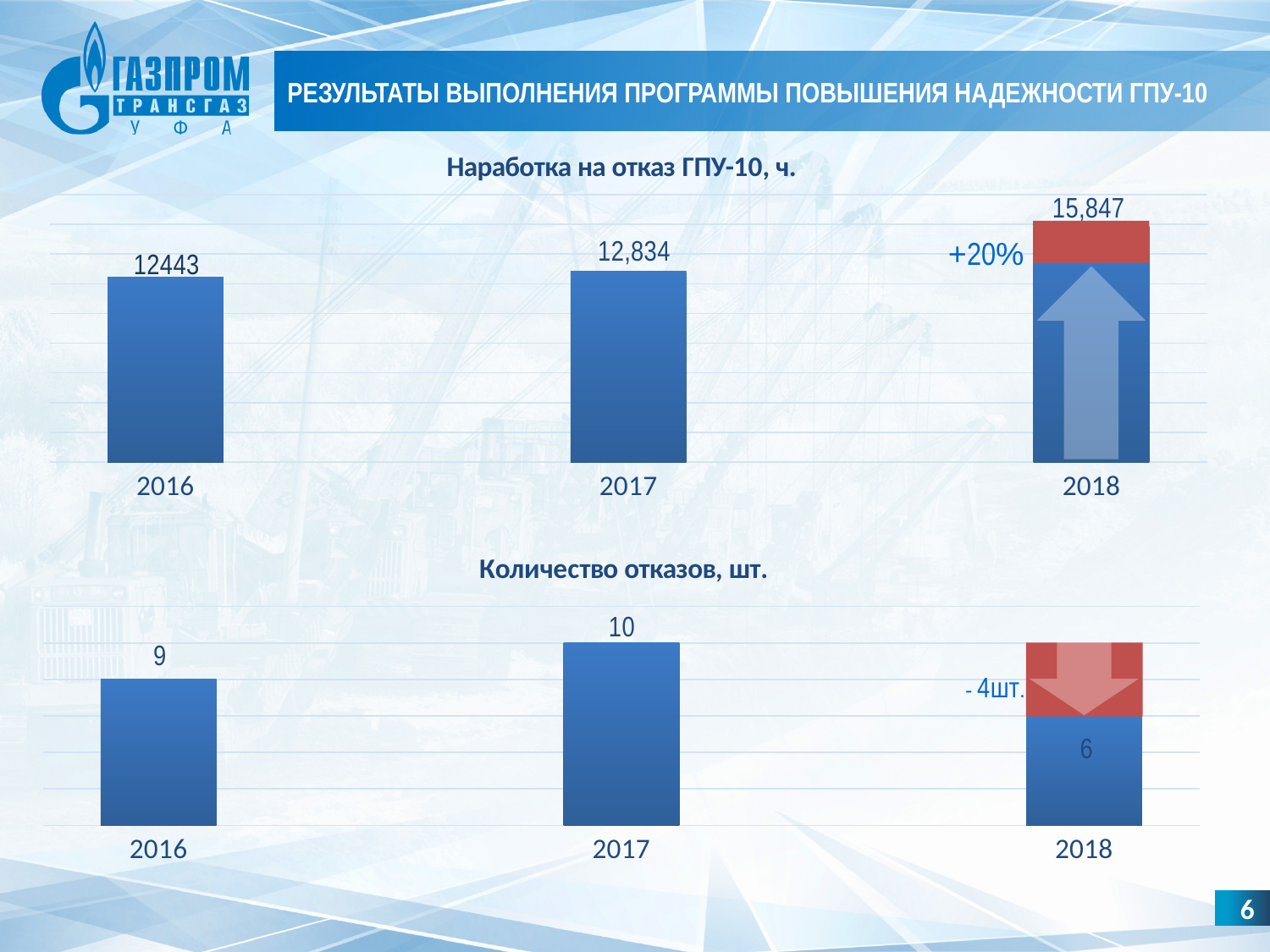
In the chart titled "Наработка на отказ ГПУ-10, ч.", which year has the highest value? 2018 In the chart titled "Наработка на отказ ГПУ-10, ч.", what is the value for 2016? 12443 In the chart titled "Наработка на отказ ГПУ-10, ч.", which year has the lowest value? 2016 In the chart titled "Наработка на отказ ГПУ-10, ч.", do the values rise or fall from 2016 to 2018? rise In the chart titled "Количество отказов, шт.", which year has the lowest value? 2018 In the chart titled "Наработка на отказ ГПУ-10, ч.", what is the difference between the 2018 and 2017 values? 3,013 In the chart titled "Наработка на отказ ГПУ-10, ч.", what is the value for 2018? 15,847 In the chart titled "Количество отказов, шт.", what is the value for 2018? 6 In the chart titled "Количество отказов, шт.", what is the difference between the 2017 and 2018 values? 4 In the chart titled "Количество отказов, шт.", what is the value for 2017? 10 In the chart titled "Наработка на отказ ГПУ-10, ч.", what percentage change is annotated next to the 2018 bar? +20% What kind of chart is the bottom chart titled "Количество отказов, шт."? bar chart